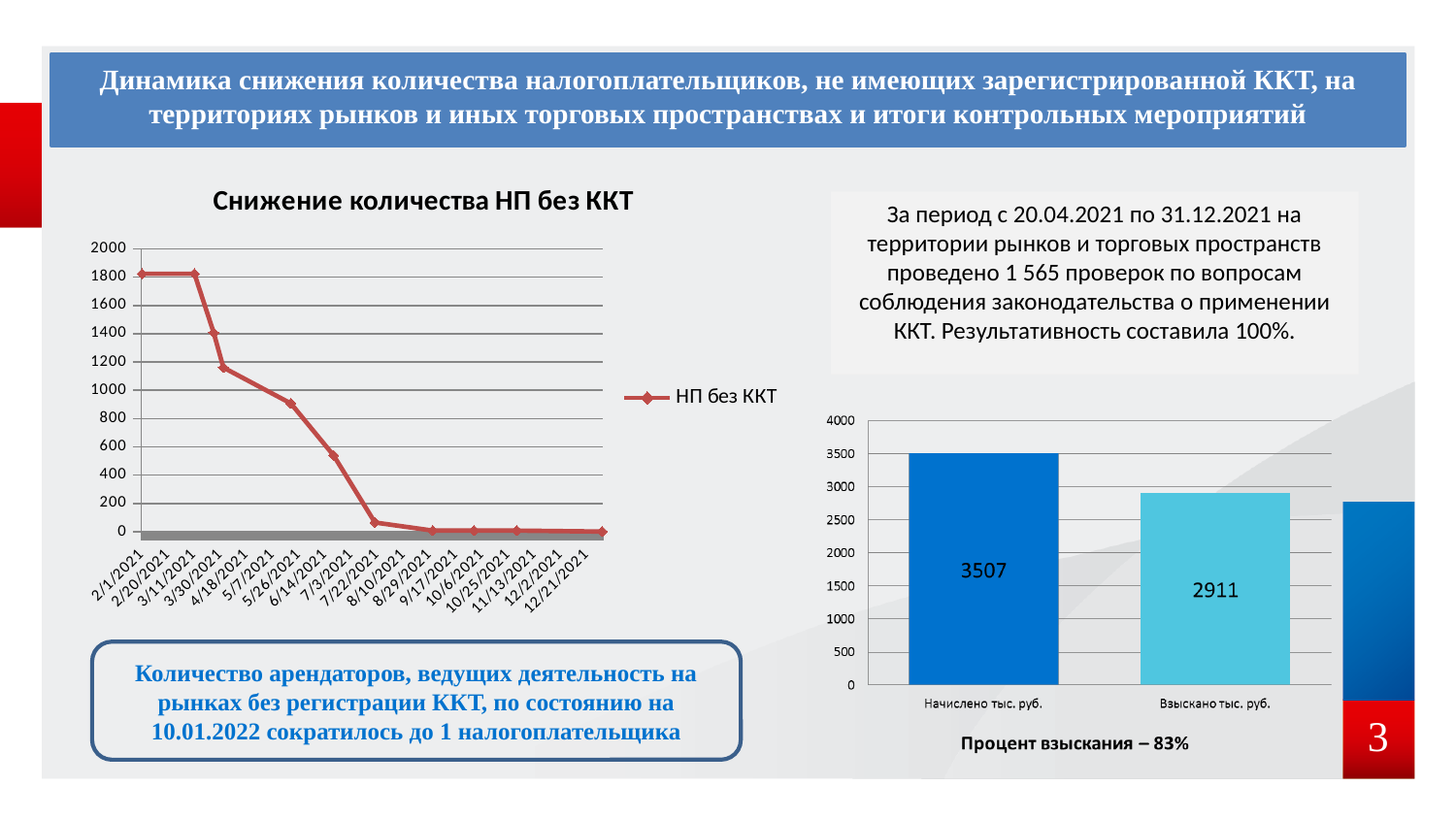
In the line chart 'Снижение количества НП без ККТ', is the value for 2/1/2021 greater or less than 1600? greater In the bar chart on the right, what is the value for 'Взыскано тыс. руб.'? 2911 In the bar chart on the right, what is the difference between 'Начислено тыс. руб.' and 'Взыскано тыс. руб.'? 596 In the bar chart on the right, what is the value for 'Начислено тыс. руб.'? 3507 What series name is shown in the legend of the line chart 'Снижение количества НП без ККТ'? НП без ККТ In the line chart 'Снижение количества НП без ККТ', do the values rise or fall along the x axis? fall In the bar chart on the right, which category has the higher value? Начислено тыс. руб. What type of chart is the chart on the right with the categories 'Начислено тыс. руб.' and 'Взыскано тыс. руб.'? bar chart In the line chart 'Снижение количества НП без ККТ', is the value for 7/22/2021 greater or less than 200? less In the line chart 'Снижение количества НП без ККТ', is the value for 4/18/2021 greater or less than 1000? greater What type of chart is the chart titled 'Снижение количества НП без ККТ'? line chart How many bars are shown in the bar chart on the right? 2